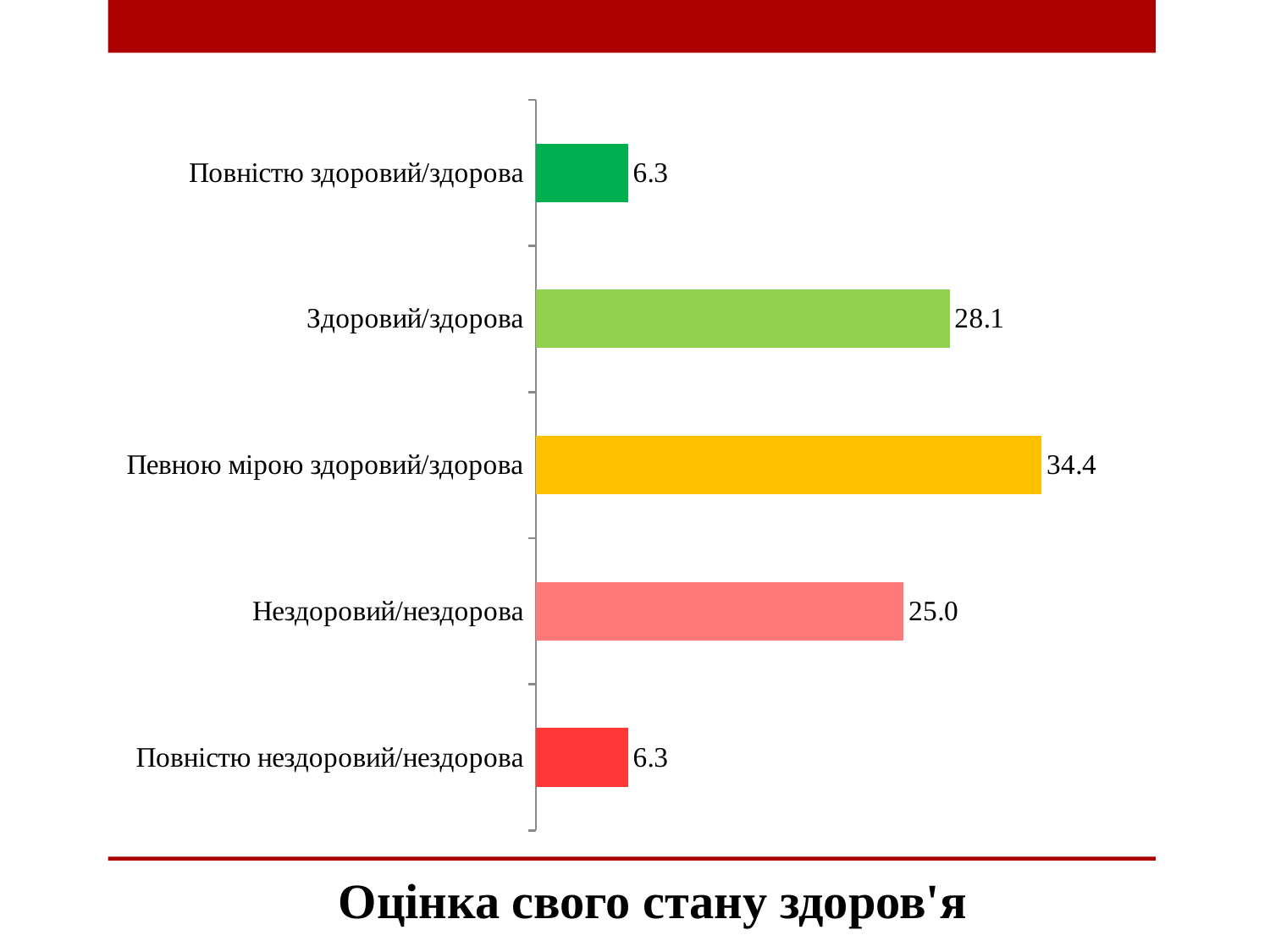
How many categories are shown in the chart? 5 What value is shown for Певною мірою здоровий/здорова? 34.4 What is the difference between the values for Здоровий/здорова and Нездоровий/нездорова? 3.1 Which category has the highest value? Певною мірою здоровий/здорова What is the title shown below the chart? Оцінка свого стану здоров'я What value is shown for Нездоровий/нездорова? 25.0 What colour is the bar for Певною мірою здоровий/здорова? Yellow What value is shown for Повністю здоровий/здорова? 6.3 What is the difference between the values for Певною мірою здоровий/здорова and Здоровий/здорова? 6.3 Which is larger, the value for Здоровий/здорова or the value for Нездоровий/нездорова? Здоровий/здорова What value is shown for Здоровий/здорова? 28.1 What kind of chart is shown on the slide? Bar chart